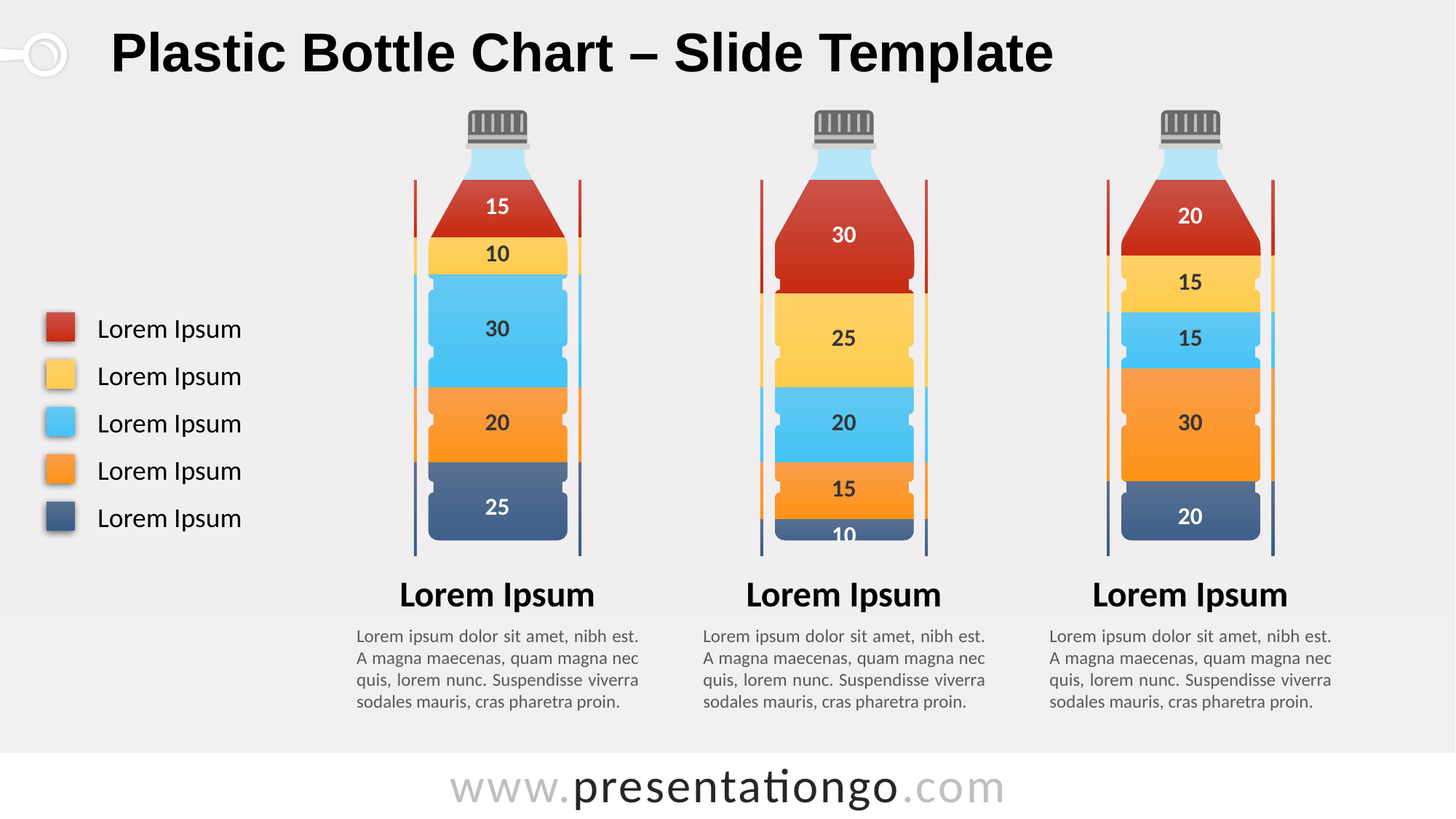
What is the total of all segments in the middle bottle chart? 100 What kind of chart is used on this slide? stacked bar chart (bottle-shaped) In the left bottle chart, what value is shown on the light blue segment? 30 How many entries does the legend on the left of the slide list? 5 In the middle bottle chart, what value is shown on the red segment at the top? 30 In the middle bottle chart, which segment has the lowest value? the dark blue segment (10) In the left bottle chart, what is the difference between the light blue segment and the yellow segment? 20 How many segments does each bottle chart contain? 5 In the left bottle chart, which segment has the highest value? the light blue segment (30) In the left bottle chart, what value is shown on the dark blue segment at the bottom? 25 In the right bottle chart, which is larger, the orange segment or the red segment? the orange segment In the right bottle chart, what value is shown on the orange segment? 30